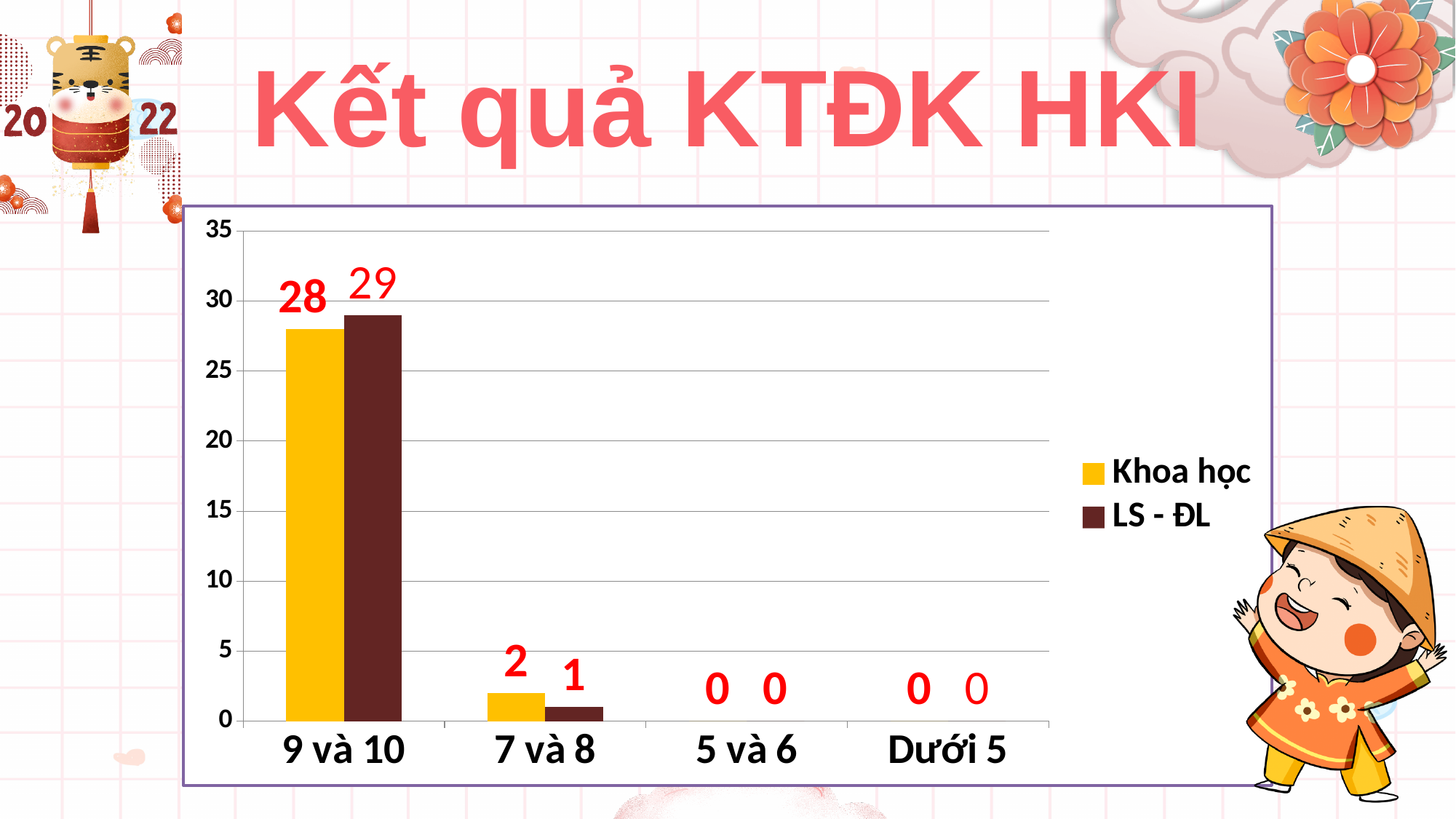
What is the value for LS - ĐL in the 7 và 8 category? 1 What kind of chart is shown on the slide? Bar chart What is the difference between the LS - ĐL and Khoa học values in the 9 và 10 category? 1 Which category has the highest value for Khoa học? 9 và 10 How many series does the legend list? 2 In the 7 và 8 category, which series has the larger value, Khoa học or LS - ĐL? Khoa học How many categories are shown on the x axis? 4 What is the value for LS - ĐL in the 9 và 10 category? 29 What is the title of the slide containing the chart? Kết quả KTĐK HKI What is the value for Khoa học in the 7 và 8 category? 2 What is the value for Khoa học in the 9 và 10 category? 28 What is the value for Khoa học in the 5 và 6 category? 0